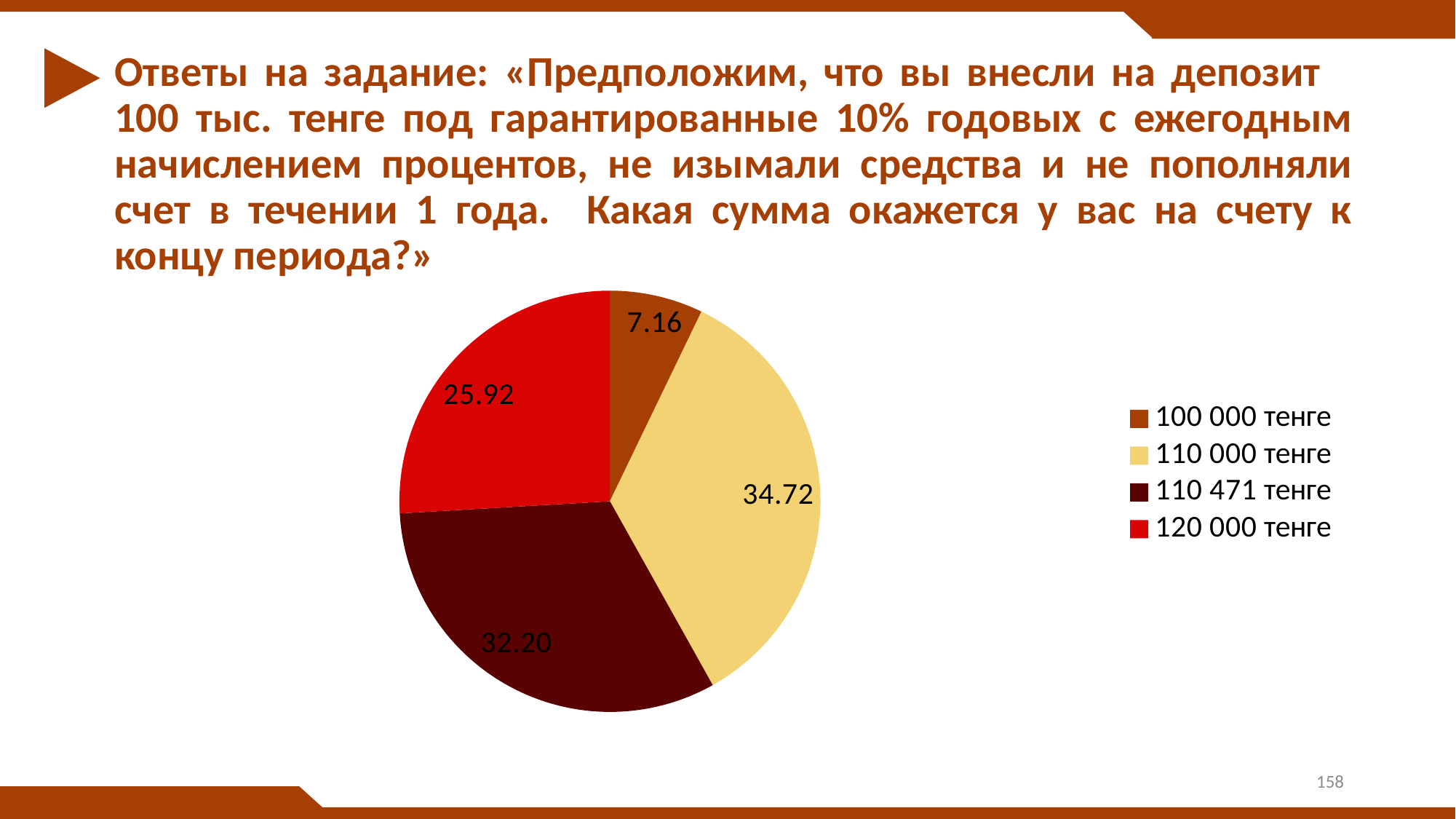
What is the difference between the values for 110 000 тенге and 110 471 тенге? 2.52 What is the value for the slice labelled 100 000 тенге? 7.16 Which answer option has the largest slice of the pie? 110 000 тенге What is the value for the slice labelled 110 000 тенге? 34.72 How many slices does the pie chart have? 4 What is the value for the slice labelled 120 000 тенге? 25.92 Which is larger: the slice for 110 471 тенге or the slice for 120 000 тенге? 110 471 тенге What kind of chart is shown on the slide? pie chart Which answer option has the smallest slice of the pie? 100 000 тенге What is the difference between the values for 120 000 тенге and 100 000 тенге? 18.76 How many entries does the legend list? 4 What is the value for the slice labelled 110 471 тенге? 32.20